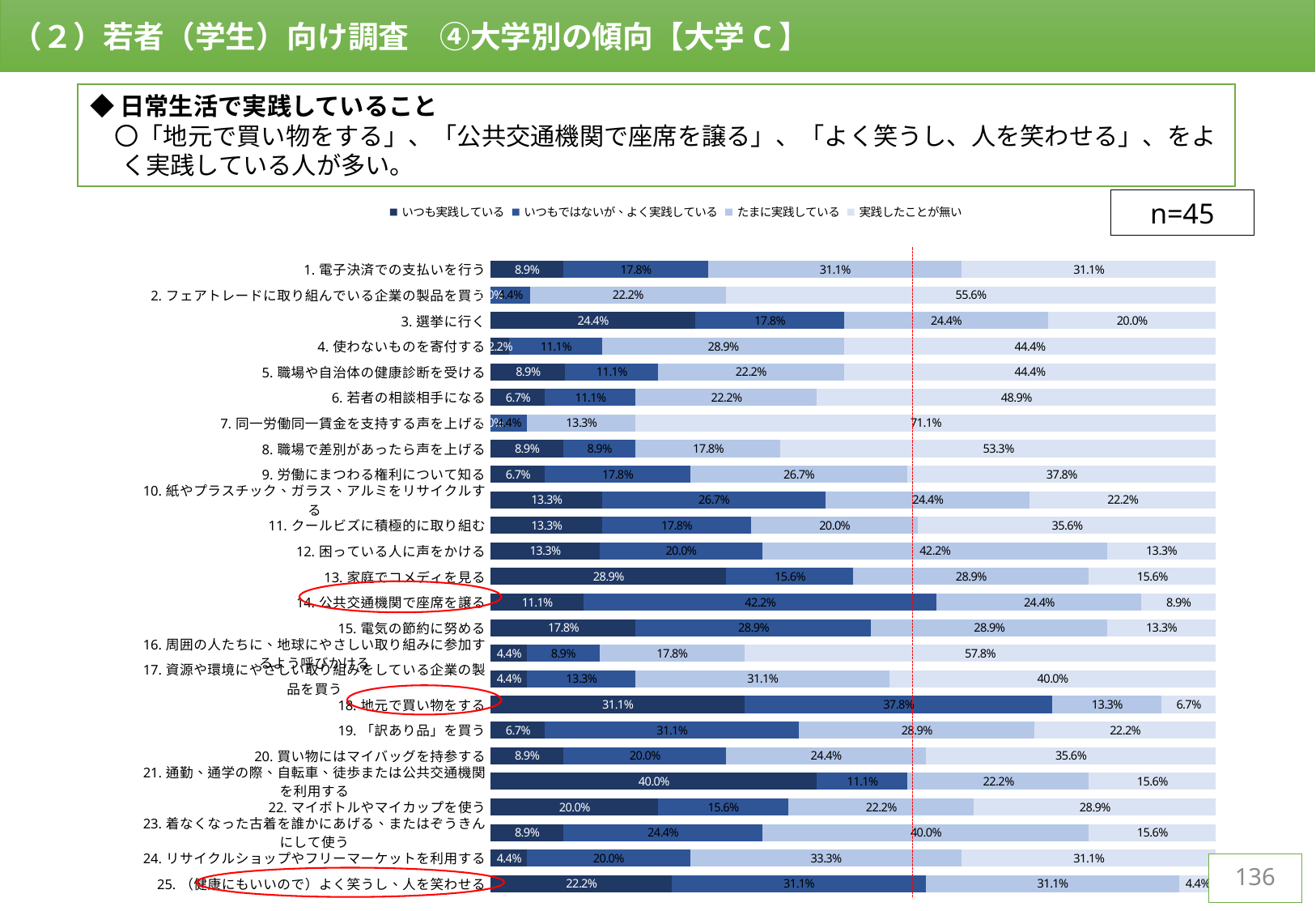
What is the difference in 「いつも実践している」 between item 21 (40.0%) and item 18 (地元で買い物をする)? 8.9 percentage points What is the value of 「実践したことが無い」 for item 7 (同一労働同一賃金を支持する声を上げる)? 71.1% Which item has the highest value for 「いつも実践している」? 21. 通勤、通学の際、自転車、徒歩または公共交通機関を利用する Which is larger: the 「いつもではないが、よく実践している」 value for item 14 (公共交通機関で座席を譲る) or for item 18 (地元で買い物をする)? Item 14 (42.2%) What sample size (n) is shown on the slide? n=45 What kind of chart is shown on the slide? Stacked bar chart What is the value of 「いつもではないが、よく実践している」 for item 14 (公共交通機関で座席を譲る)? 42.2% What is the value of 「いつも実践している」 for item 21 (通勤、通学の際、自転車、徒歩または公共交通機関を利用する)? 40.0% How many categories (items) are plotted in the chart? 25 Which item has the lowest value for 「実践したことが無い」? 25. （健康にもいいので）よく笑うし、人を笑わせる How many series does the legend list? 4 Which item has the highest value for 「実践したことが無い」? 7. 同一労働同一賃金を支持する声を上げる